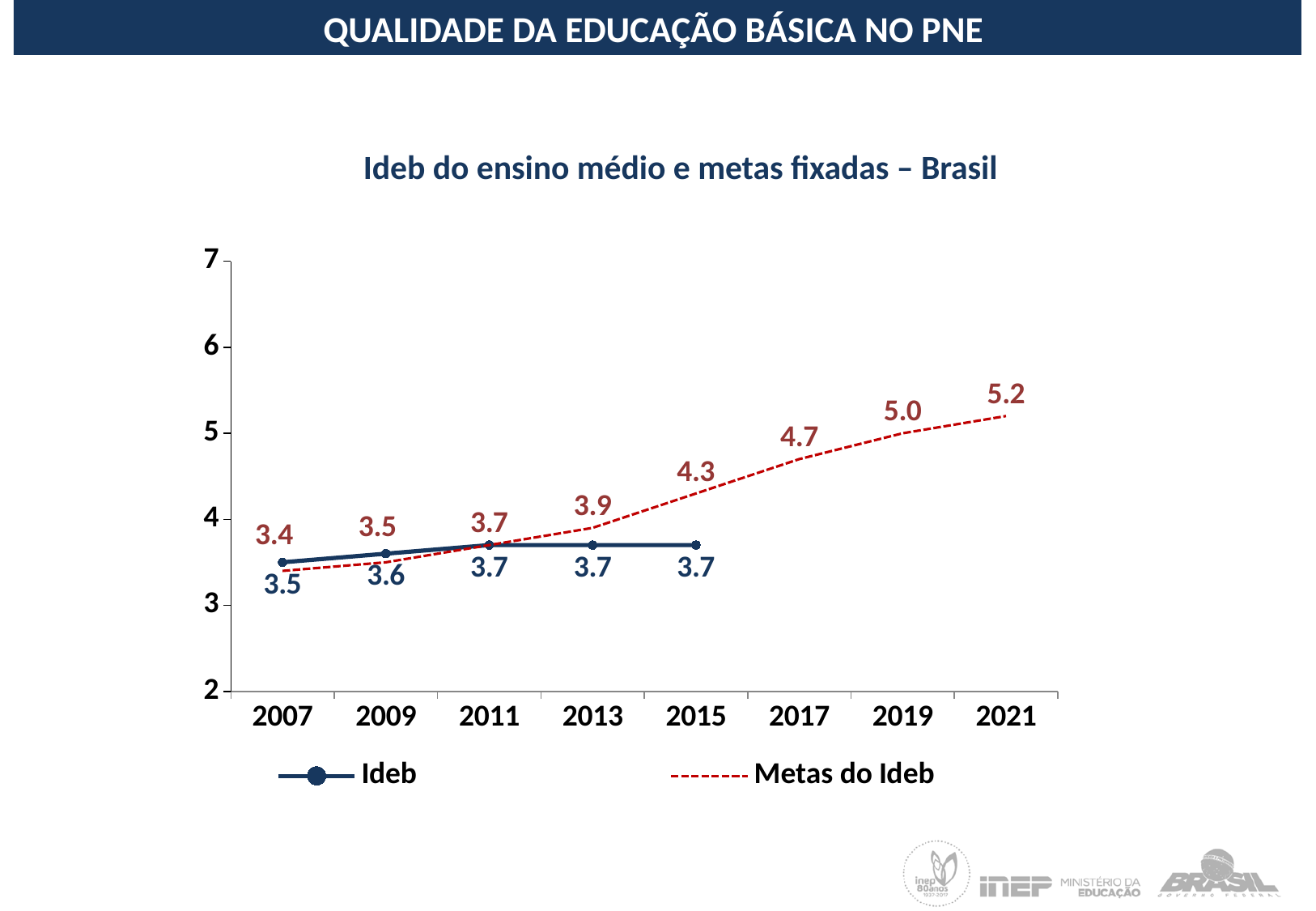
In which year is the Metas do Ideb value highest? 2021 What is the Metas do Ideb value for 2021? 5.2 What kind of chart is shown on the slide? Line chart How many series does the legend list? 2 How many years are shown on the x axis? 8 What is the difference between the Metas do Ideb value and the Ideb value in 2015? 0.6 What is the Ideb value for 2015? 3.7 Which is larger in 2007, the Ideb value or the Metas do Ideb value? Ideb What is the Ideb value for 2007? 3.5 In which year is the Ideb value lowest? 2007 What is the Metas do Ideb value for 2013? 3.9 Do the Metas do Ideb values rise or fall from 2007 to 2021? Rise